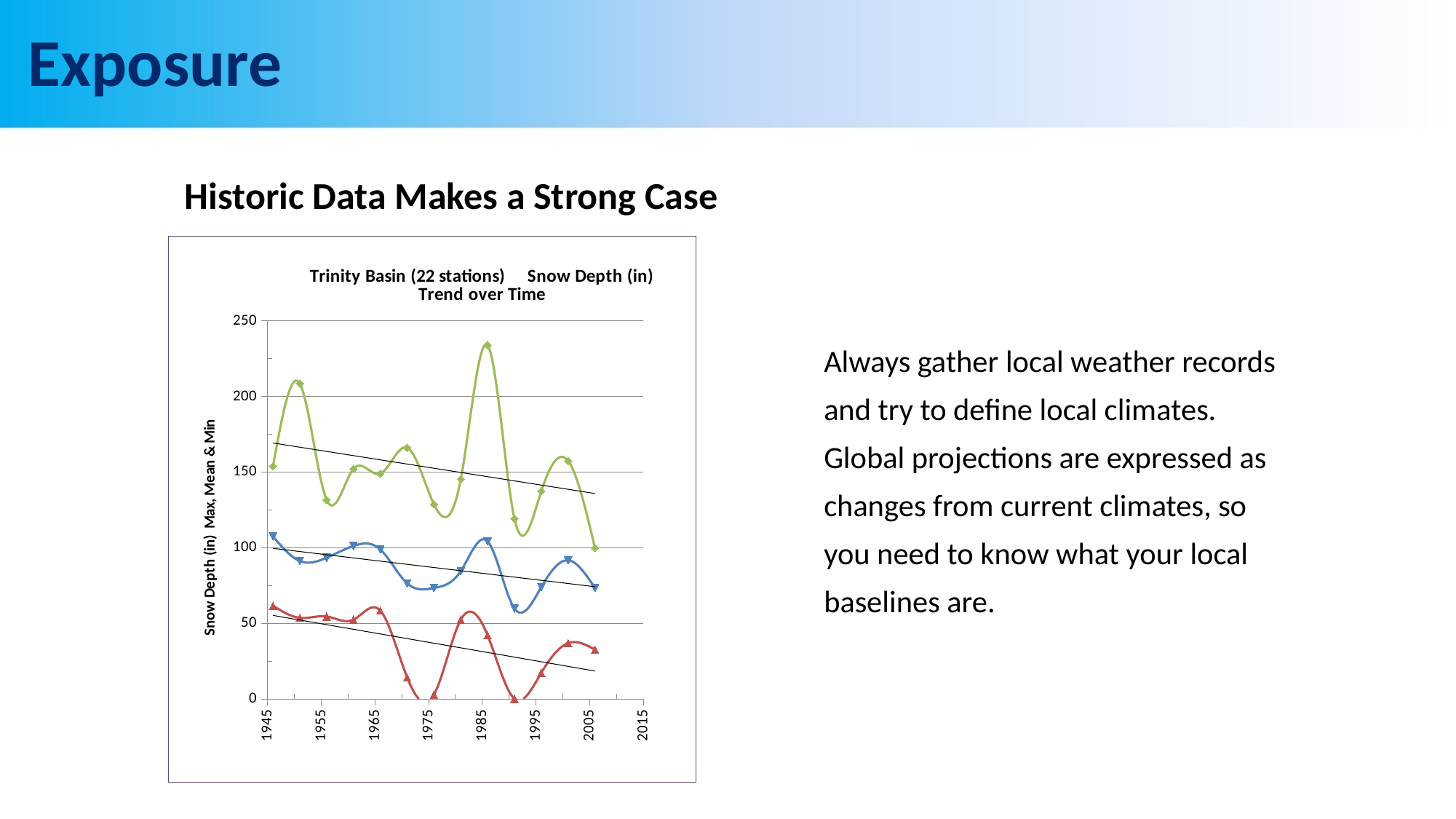
Is the value of the red line at 1965 greater or less than 50? greater Do the straight trend lines on the chart rise or fall from 1945 to 2005? Fall What is the highest value shown on the vertical axis of the chart? 250 Is the highest point of the green line greater or less than 200? greater Is the value of the blue line at 1945 greater or less than 100? greater What kind of chart is shown on the slide? Line chart What is the label on the vertical axis of the chart? Snow Depth (in) Max, Mean & Min Which coloured line has the highest values throughout the chart? Green What is the title of the chart? Trinity Basin (22 stations) Snow Depth (in) Trend over Time How many coloured data lines are plotted on the chart? 3